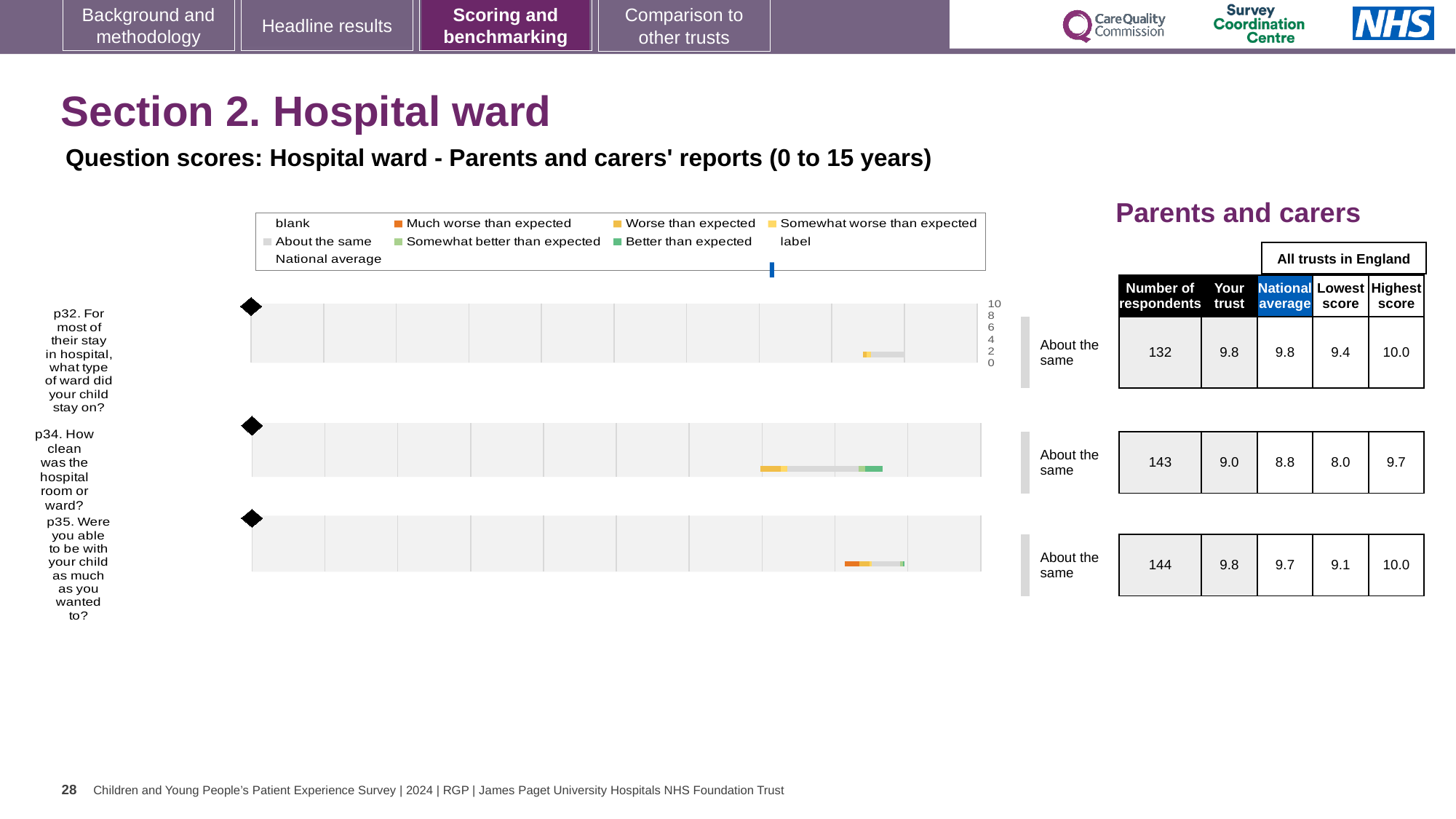
What is the lowest score across all trusts in England for question p34? 8.0 Which question has the lowest 'Your trust' score? p34 What is the difference between the 'Your trust' score and the national average for question p34? 0.2 Which has the larger 'Your trust' score, question p32 or question p34? p32 Which question has the highest number of respondents? p35 What is the highest score across all trusts in England for question p32? 10.0 What is the national average score for question p35 (were you able to be with your child as much as you wanted to)? 9.7 What is the 'Your trust' score for question p34 (how clean was the hospital room or ward)? 9.0 How many respondents are shown for question p32 (what type of ward did your child stay on)? 132 What kind of chart is used to show the question scores? Bar chart How many questions are plotted on the slide? 3 What benchmark category is shown next to the chart for question p35? About the same